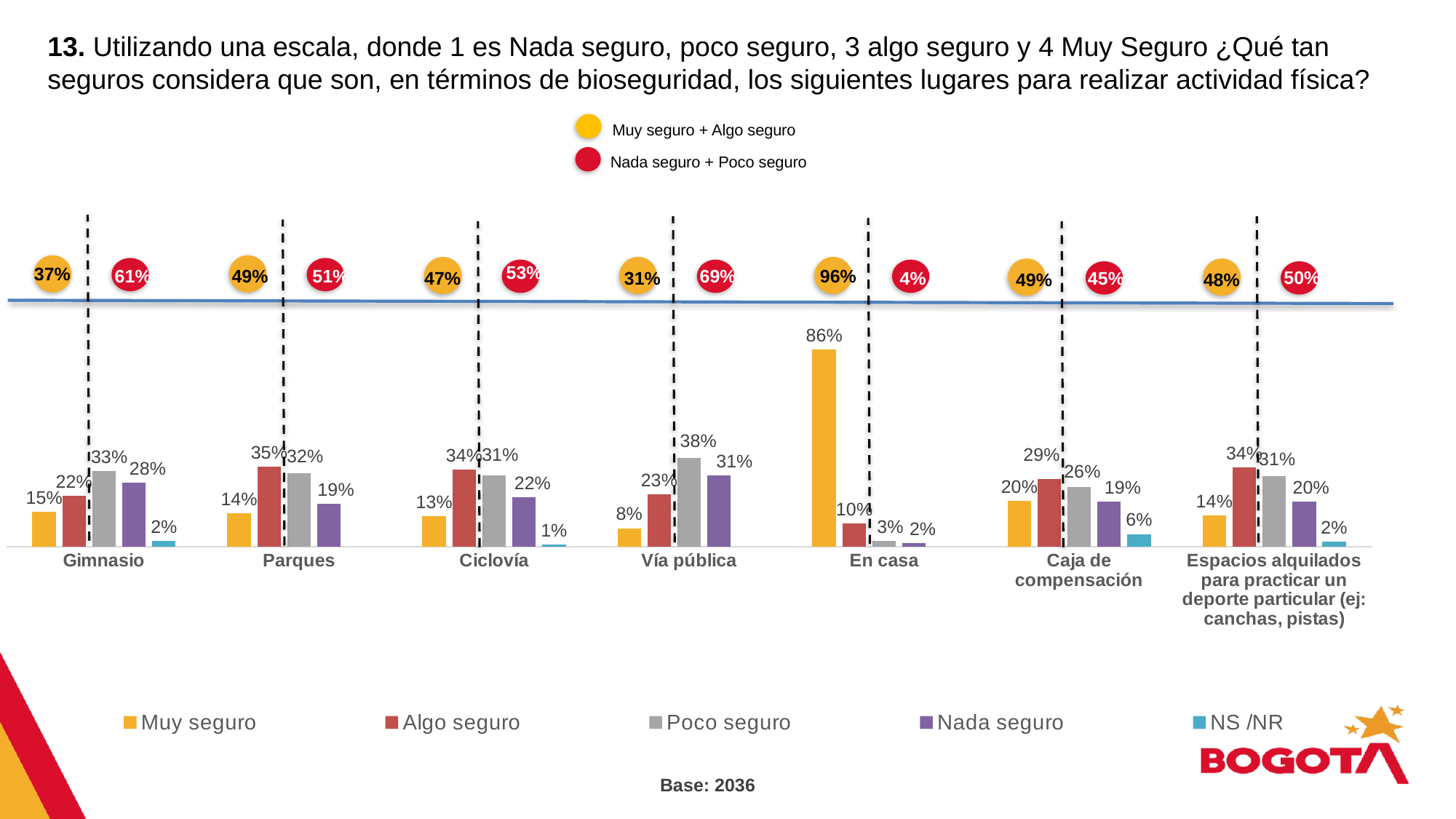
What is the value for Poco seguro in the Vía pública category? 38% Which category has the lowest value for Muy seguro? Vía pública What kind of chart is shown on the slide? Bar chart What is the difference between the Algo seguro value for Parques and the Algo seguro value for Gimnasio? 13% What is the value for NS /NR in the Caja de compensación category? 6% Which category has the highest value for Muy seguro? En casa Which is larger: the Poco seguro value for Ciclovía or the Poco seguro value for Vía pública? Vía pública What is the combined 'Nada seguro + Poco seguro' percentage shown in the red circle for Vía pública? 69% How many series does the legend at the bottom of the chart list? 5 How many categories (places) are shown on the x axis? 7 What is the value for Nada seguro in the Gimnasio category? 28% What is the value for Muy seguro in the En casa category? 86%